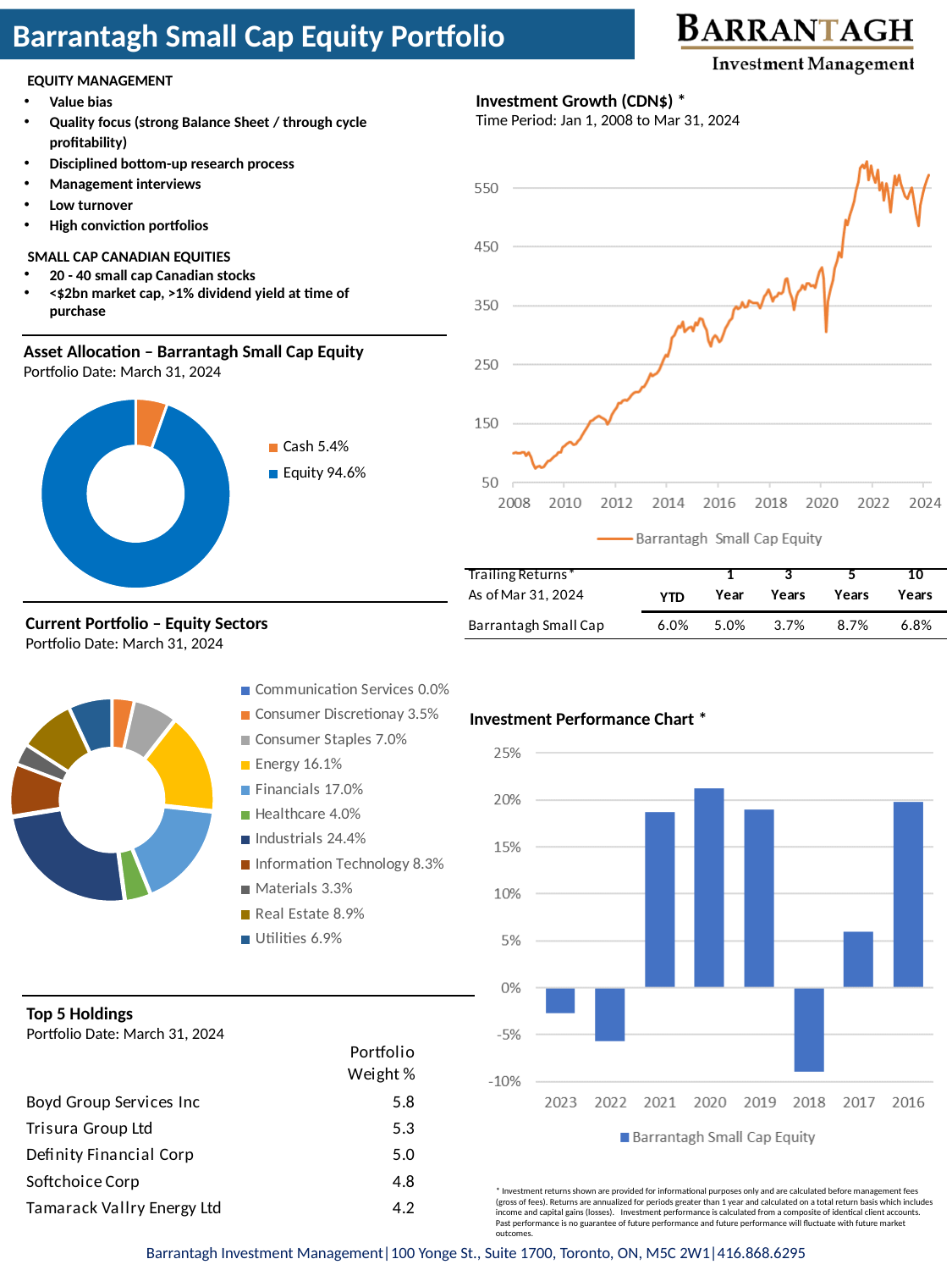
In the Investment Performance Chart, which year has the lowest value? 2018 How many sectors are listed in the legend of the Current Portfolio – Equity Sectors chart? 11 What kind of chart is the Investment Growth (CDN$) chart? Line chart In the Current Portfolio – Equity Sectors chart, which sector has the lowest weight? Communication Services In the Investment Growth (CDN$) chart, is the value at 2014 greater or less than 250? greater In the Asset Allocation chart, what is the value for Equity? 94.6% In the Current Portfolio – Equity Sectors chart, which sector has the highest weight? Industrials In the Current Portfolio – Equity Sectors chart, what is the value for Energy? 16.1% In the Current Portfolio – Equity Sectors chart, what is the difference between Financials and Energy? 0.9% In the Investment Performance Chart, is the value for 2017 greater or less than 10%? less In the Asset Allocation chart, what is the value for Cash? 5.4% In the Investment Performance Chart, which year has the highest value? 2020